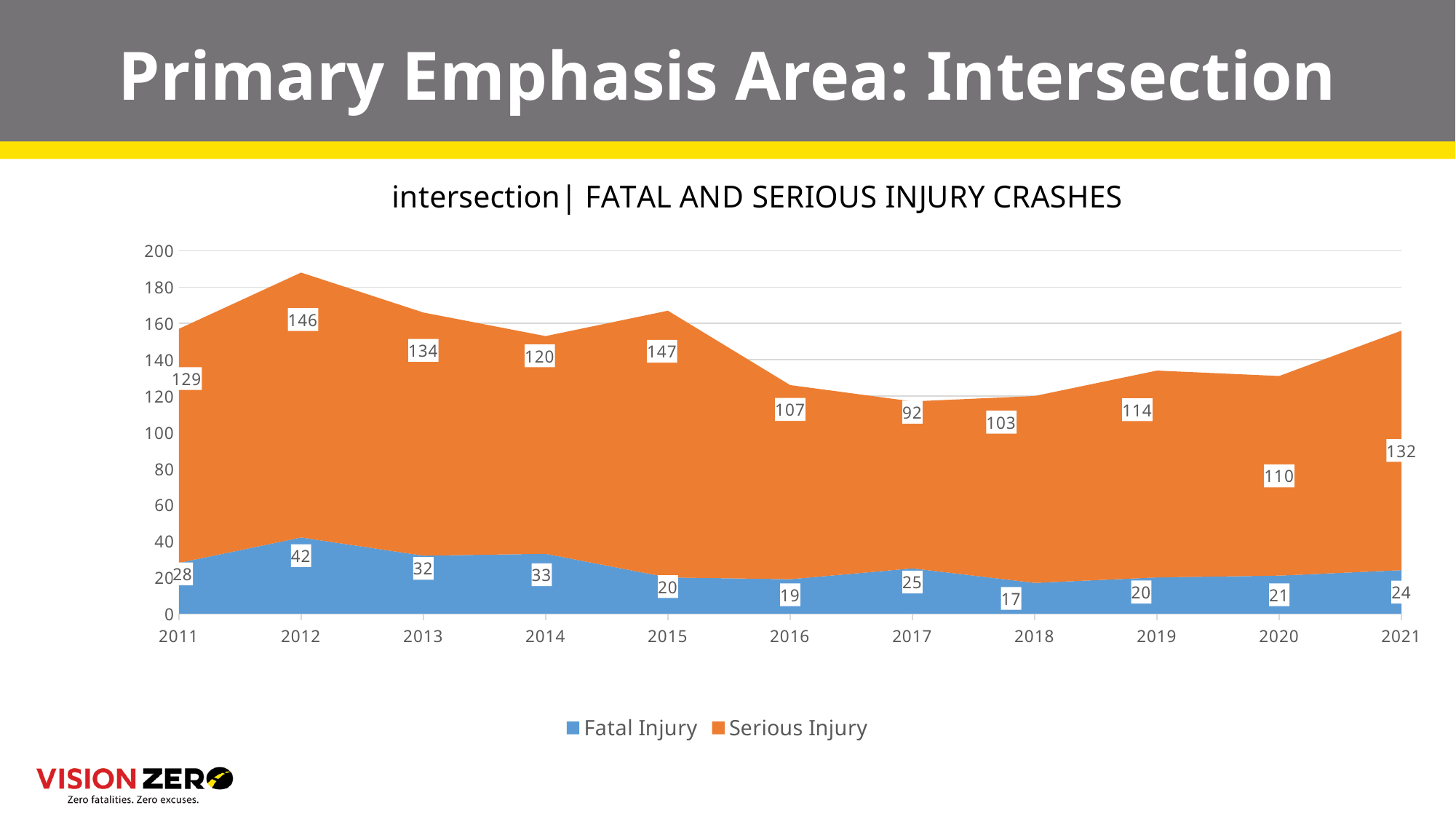
How many years are shown on the x axis? 11 Which year has the highest Fatal Injury value? 2012 What is the difference between the Serious Injury values for 2012 and 2017? 54 What is the total of Fatal Injury and Serious Injury for 2012? 188 How many series does the legend list? 2 Which colour represents Serious Injury in the chart? Orange Which is larger, the Fatal Injury value for 2013 or for 2014? 2014 What kind of chart is shown on the slide? Stacked area chart Which year has the lowest Serious Injury value? 2017 What is the Serious Injury value for 2015? 147 What is the Fatal Injury value for 2018? 17 What is the Serious Injury value for 2021? 132